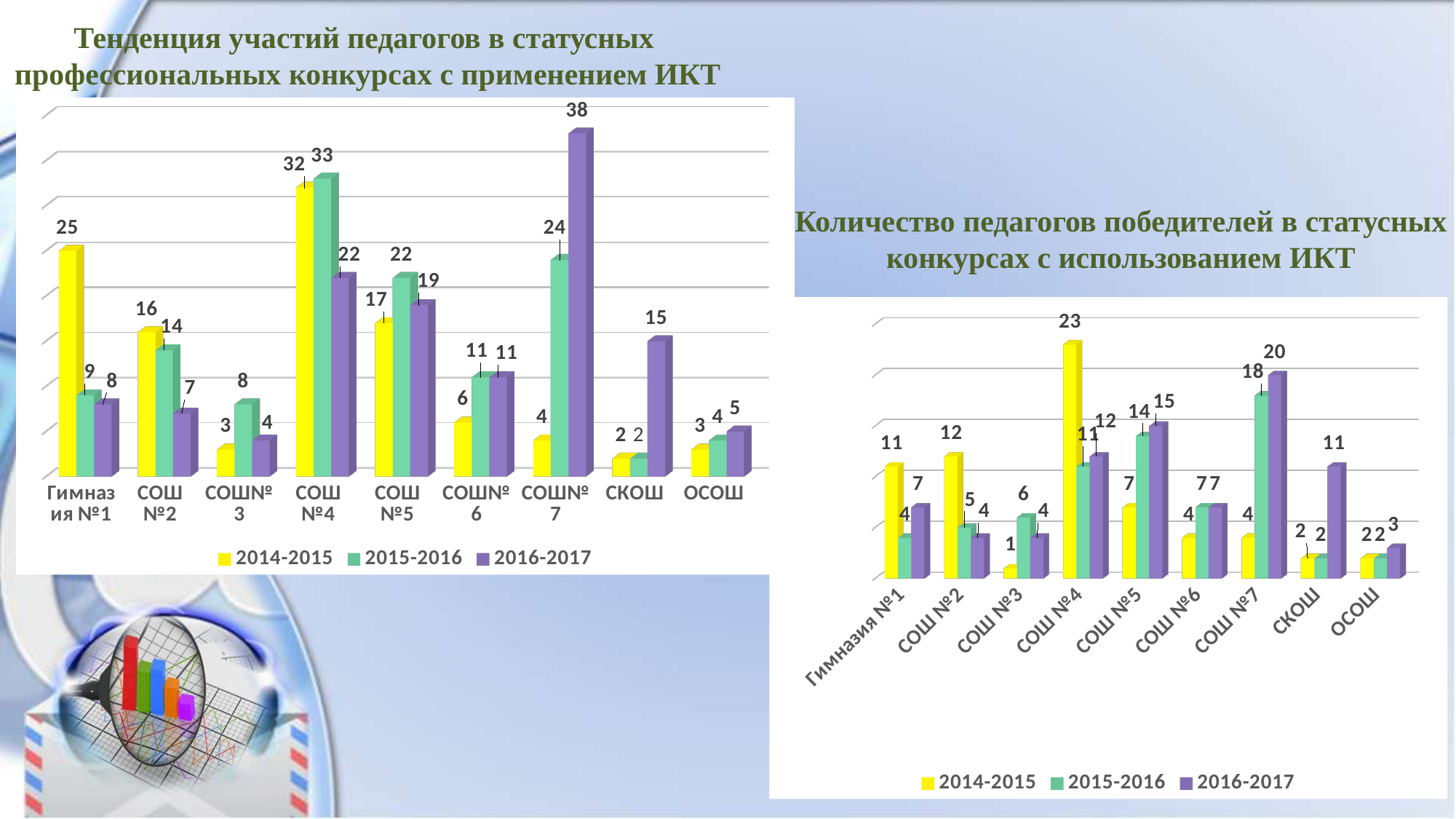
In the left chart (Тенденция участий педагогов...), how many series does the legend list? 3 In the left chart (Тенденция участий педагогов...), how many categories are shown on the x axis? 9 What type of chart is the right chart (Количество педагогов победителей...)? bar chart In the left chart (Тенденция участий педагогов...), what is the value for Гимназия №1 in 2014-2015? 25 In the right chart (Количество педагогов победителей...), which is larger for СОШ №7: the 2015-2016 value or the 2016-2017 value? 2016-2017 In the left chart (Тенденция участий педагогов...), which category has the highest value in the 2015-2016 series? СОШ №4 In the right chart (Количество педагогов победителей...), which category has the lowest value in the 2014-2015 series? СОШ №3 In the left chart (Тенденция участий педагогов...), what is the value for СОШ №7 in 2016-2017? 38 In the right chart (Количество педагогов победителей...), what is the value for СОШ №5 in 2016-2017? 15 In the right chart (Количество педагогов победителей...), what is the difference between the 2016-2017 and 2015-2016 values for СКОШ? 9 In the right chart (Количество педагогов победителей...), what is the value for СОШ №4 in 2014-2015? 23 In the left chart (Тенденция участий педагогов...), what is the difference between the 2016-2017 and 2014-2015 values for СКОШ? 13